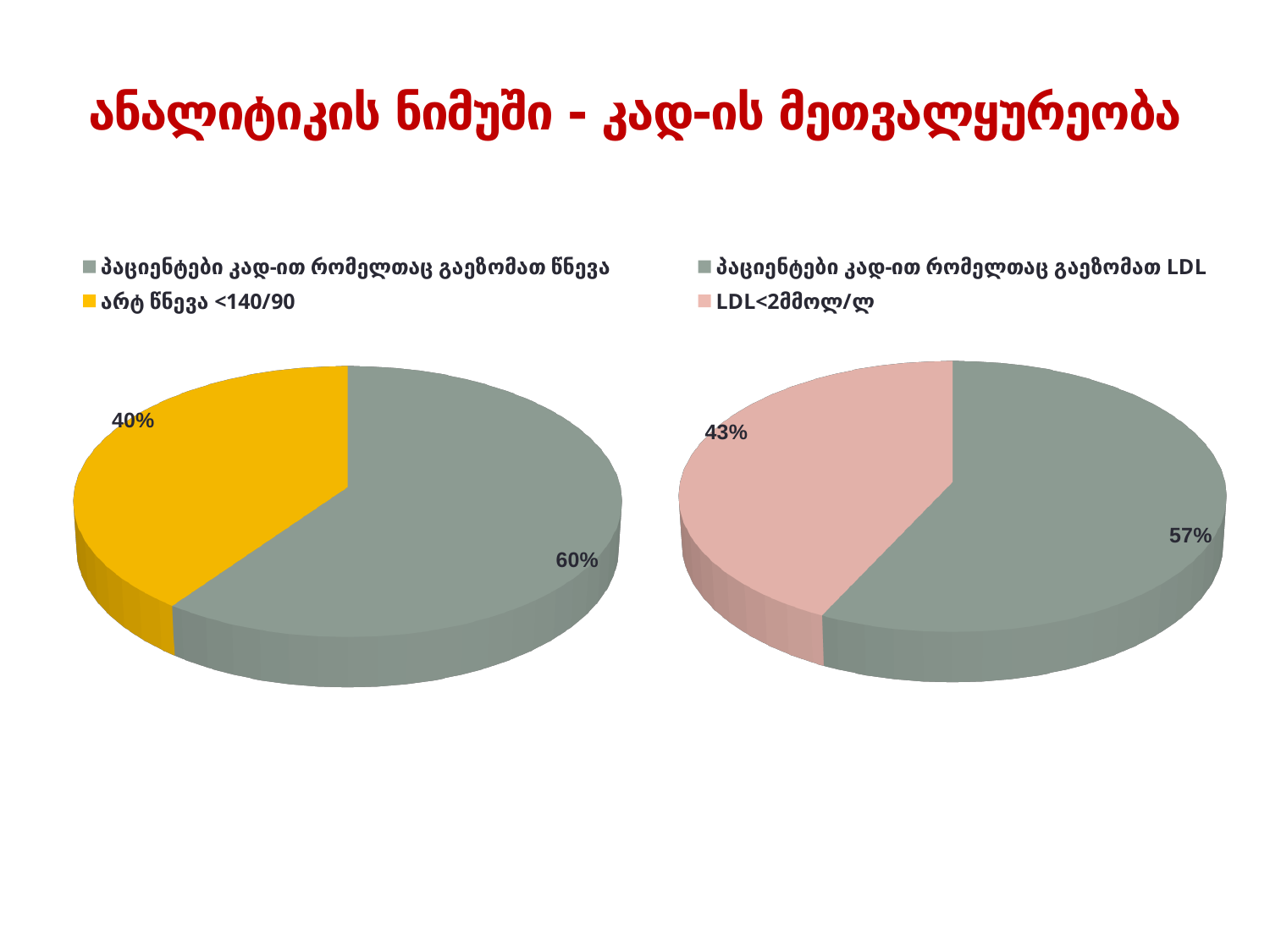
In the right pie chart, what is the difference in percentage points between the 57% slice and the 43% slice? 14 In the left pie chart, what share is shown for the yellow slice labelled "არტ წნევა <140/90"? 40% What kind of chart is the right chart on the slide? pie chart What kind of chart is the left chart on the slide? pie chart In the left pie chart, what is the difference in percentage points between the 60% slice and the 40% slice? 20 In the right pie chart, what share is shown for the grey slice labelled "პაციენტები კად-ით რომელთაც გაეზომათ LDL"? 57% In the left pie chart, what share is shown for the grey slice labelled "პაციენტები კად-ით რომელთაც გაეზომათ წნევა"? 60% In the right pie chart, which slice is the smallest? LDL<2მმოლ/ლ How many slices does the right pie chart have? 2 In the left pie chart, which slice is the largest? პაციენტები კად-ით რომელთაც გაეზომათ წნევა How many entries does the legend of the left pie chart list? 2